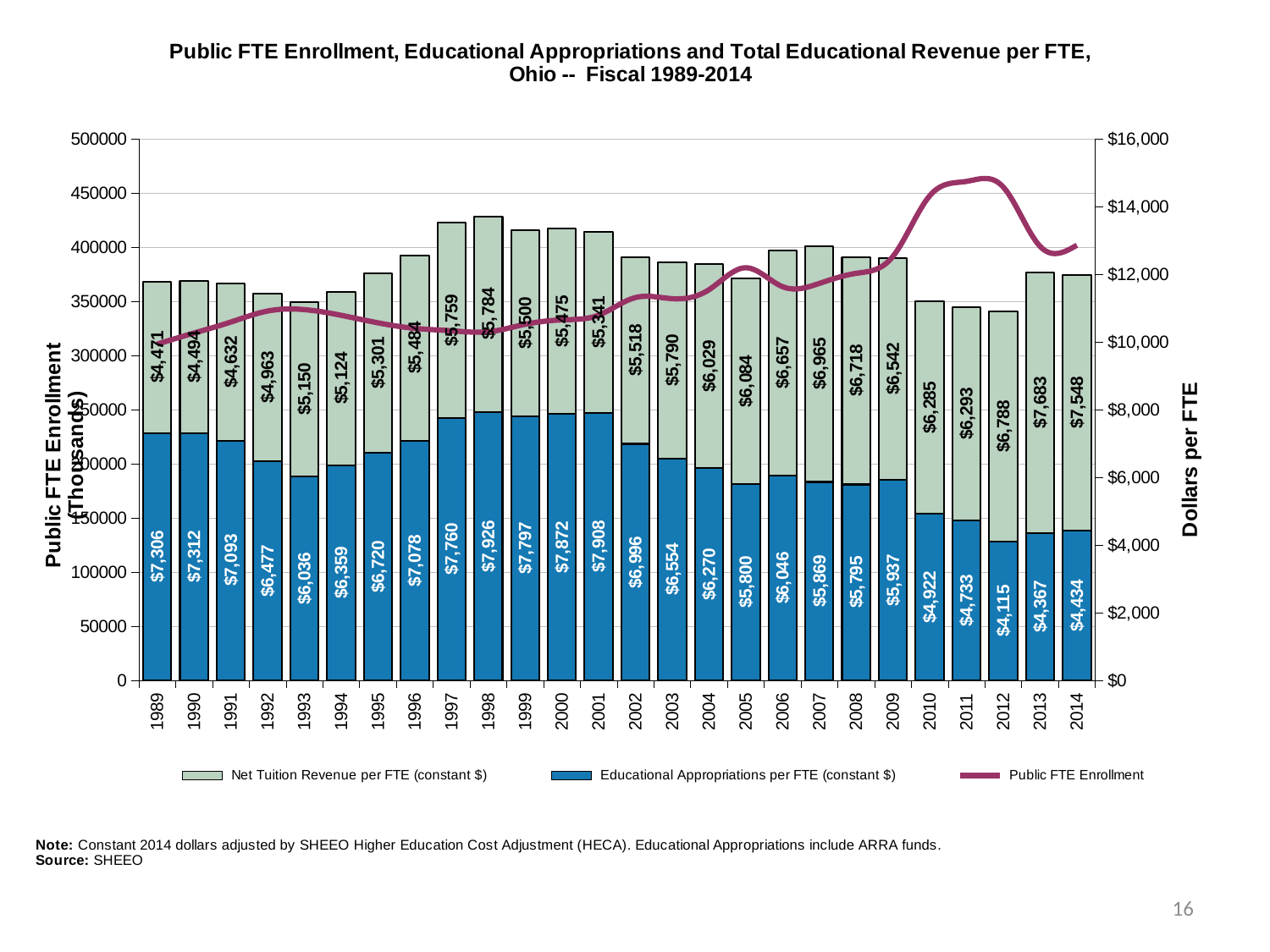
Which year has the lowest Educational Appropriations per FTE? 2012 Which year has the highest Net Tuition Revenue per FTE? 2013 Is the Public FTE Enrollment value for 2011 greater or less than 450000? greater What is the Net Tuition Revenue per FTE value for 2013? $7,683 How many series does the legend list? 3 What is the Educational Appropriations per FTE value for 1998? $7,926 Which is larger in 2005: Educational Appropriations per FTE or Net Tuition Revenue per FTE? Net Tuition Revenue per FTE What kind of chart is this? Stacked bar chart with a line How many fiscal years are shown on the x axis? 26 What is the total of the stacked bar (appropriations plus net tuition revenue) for 2014? $11,982 What is the difference between Educational Appropriations per FTE in 1989 and in 2014? $2,872 Do Educational Appropriations per FTE rise or fall from 2009 to 2012? fall